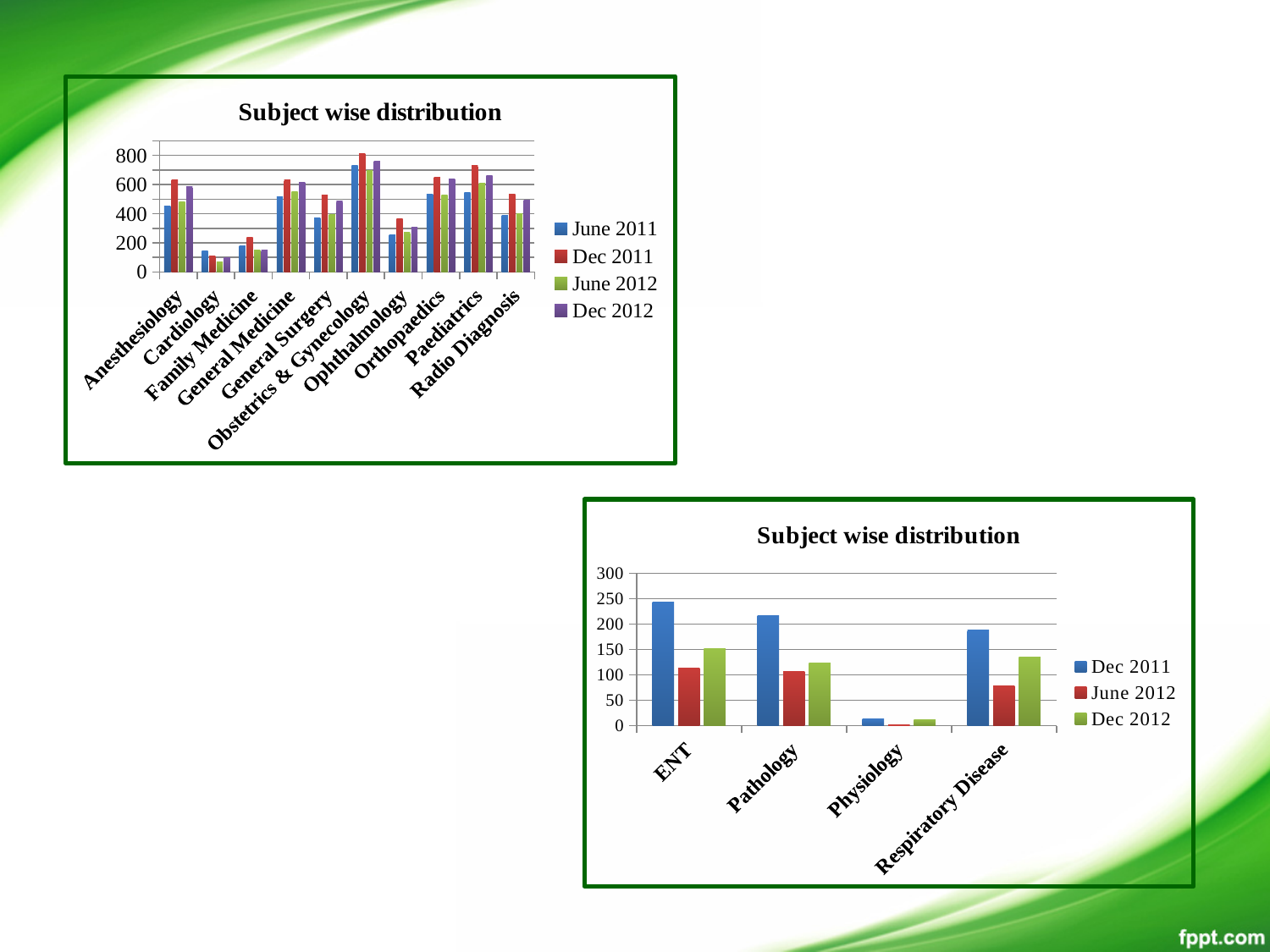
How many series does the legend of the bottom-right chart list? 3 How many subject categories are shown on the x axis of the bottom-right chart? 4 In the top-left chart, is the June 2011 value for Cardiology greater or less than 200? less What type of chart is the chart in the top-left of the slide? bar chart How many series does the legend of the top-left chart list? 4 In the top-left chart, which subject has the tallest bar overall? Obstetrics & Gynecology How many subject categories are shown on the x axis of the top-left chart? 10 In the top-left chart, is the June 2011 value for Obstetrics & Gynecology greater or less than 600? greater In the bottom-right chart, is the Dec 2011 value for ENT greater or less than 200? greater In the bottom-right chart, which is larger: the Dec 2011 value for ENT or the Dec 2011 value for Pathology? ENT In the bottom-right chart, which subject has the lowest values across all series? Physiology